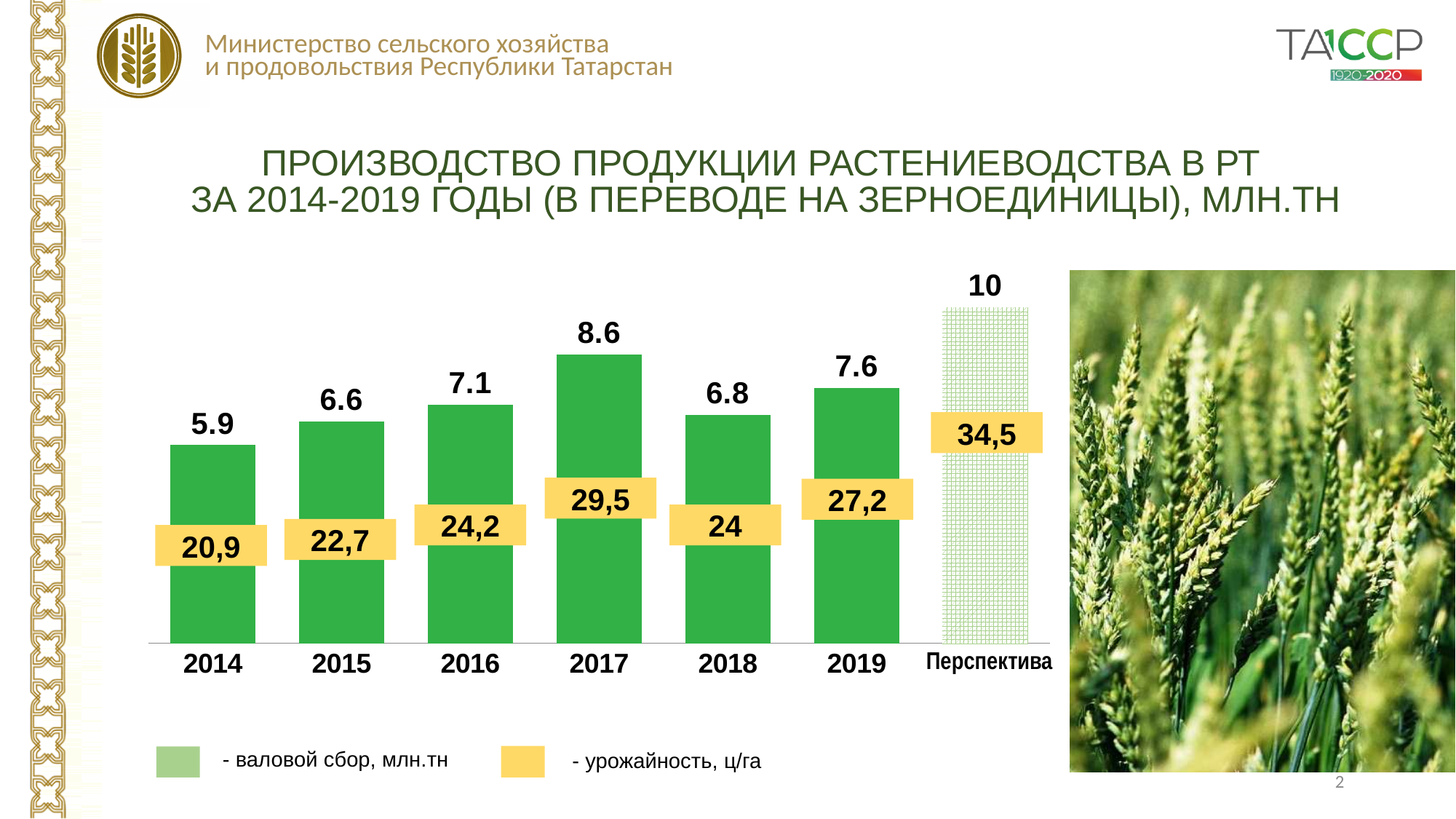
How many series does the legend list? 2 How many categories are shown along the x axis of the chart? 7 What yield value is shown for 2018? 24 What kind of chart is shown on the slide? bar chart What gross harvest value is shown for the Перспектива bar? 10 What yield (урожайность, ц/га) is shown for 2019? 27,2 Among the years 2014 to 2019, which year has the highest gross harvest? 2017 What is the gross harvest (валовой сбор) value shown for 2017? 8.6 Which year has the larger gross harvest, 2016 or 2018? 2016 What is the difference between the gross harvest values for 2019 and 2018? 0.8 Which year has the lowest gross harvest value? 2014 Do the gross harvest values rise or fall from 2014 to 2017? rise